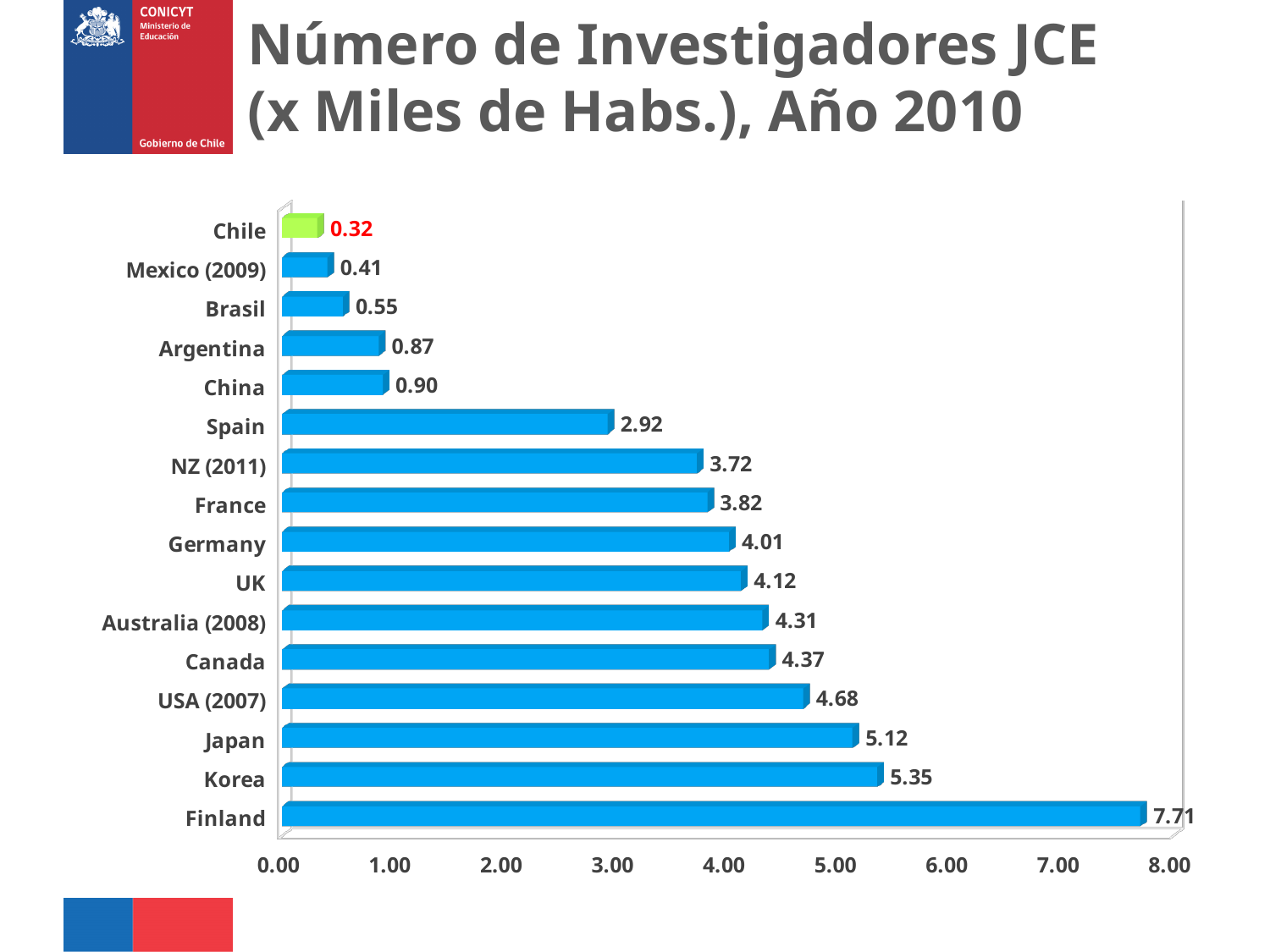
Which bar is coloured green instead of blue? Chile What is the difference between the values for Brasil and Chile? 0.23 What is the value for Chile? 0.32 What is the difference between the values for Finland and Korea? 2.36 How many countries are shown in the chart? 16 Which country has the highest value? Finland What is the value for Finland? 7.71 Which has a larger value, Japan or USA (2007)? Japan What is the value for Spain? 2.92 Is the value for Spain greater or less than 3.00? less What kind of chart is shown on the slide? bar chart Which country has the lowest value? Chile